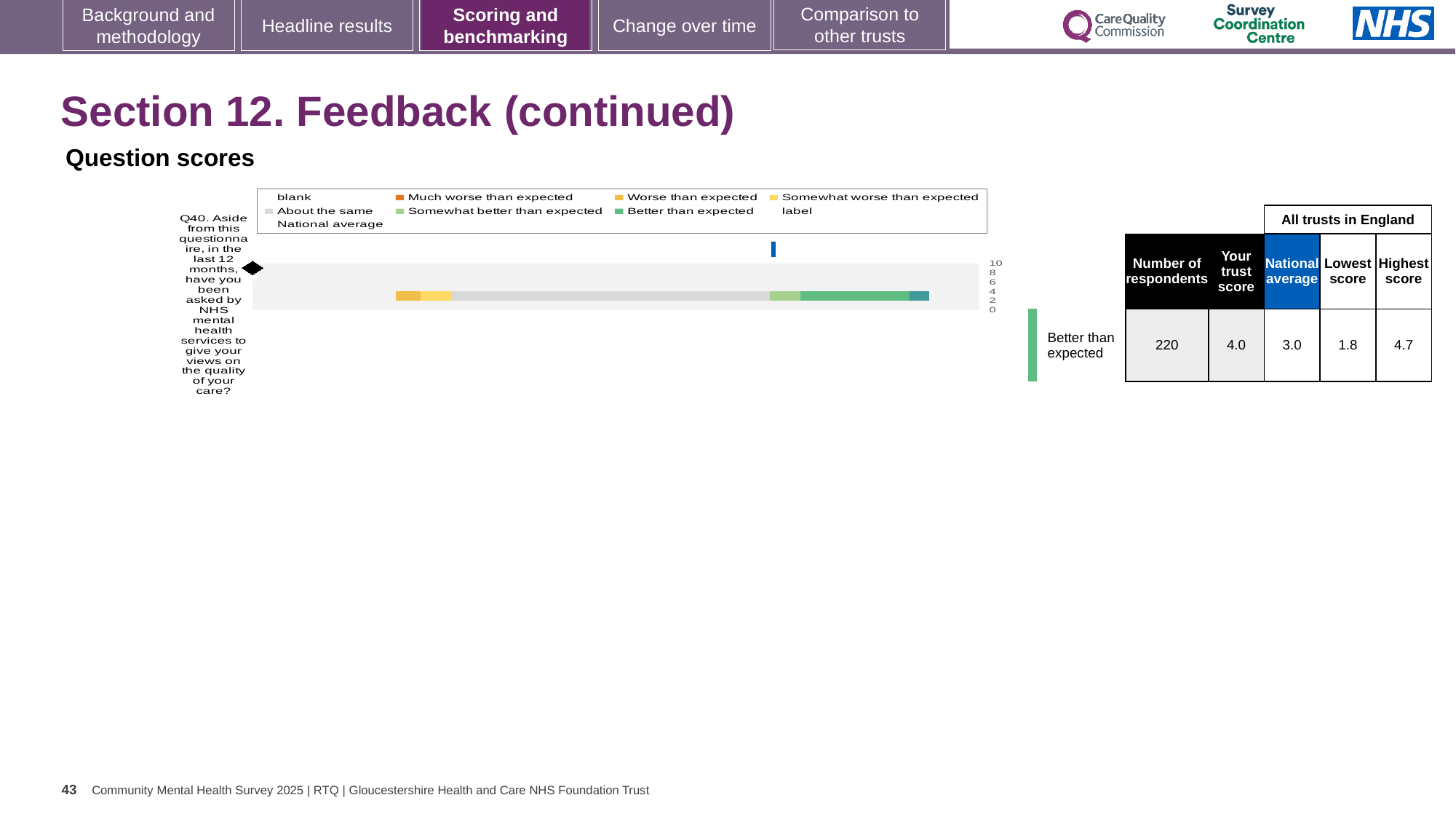
How many respondents answered Q40? 220 What is the lowest score among all trusts in England for Q40? 1.8 What is the trust's score for Q40 shown in the table next to the chart? 4.0 By how much does the trust's score for Q40 exceed the national average? 1.0 What kind of chart is used to show the Q40 question score? bar chart What colour in the legend represents 'Better than expected'? green What is the difference between the highest and lowest scores for Q40 across all trusts in England? 2.9 What is the highest score among all trusts in England for Q40? 4.7 Which is larger for Q40, the trust's score or the national average? the trust's score What is the national average score for Q40? 3.0 How many survey questions are plotted on the chart? 1 Which benchmarking category is the trust's Q40 score placed in? Better than expected